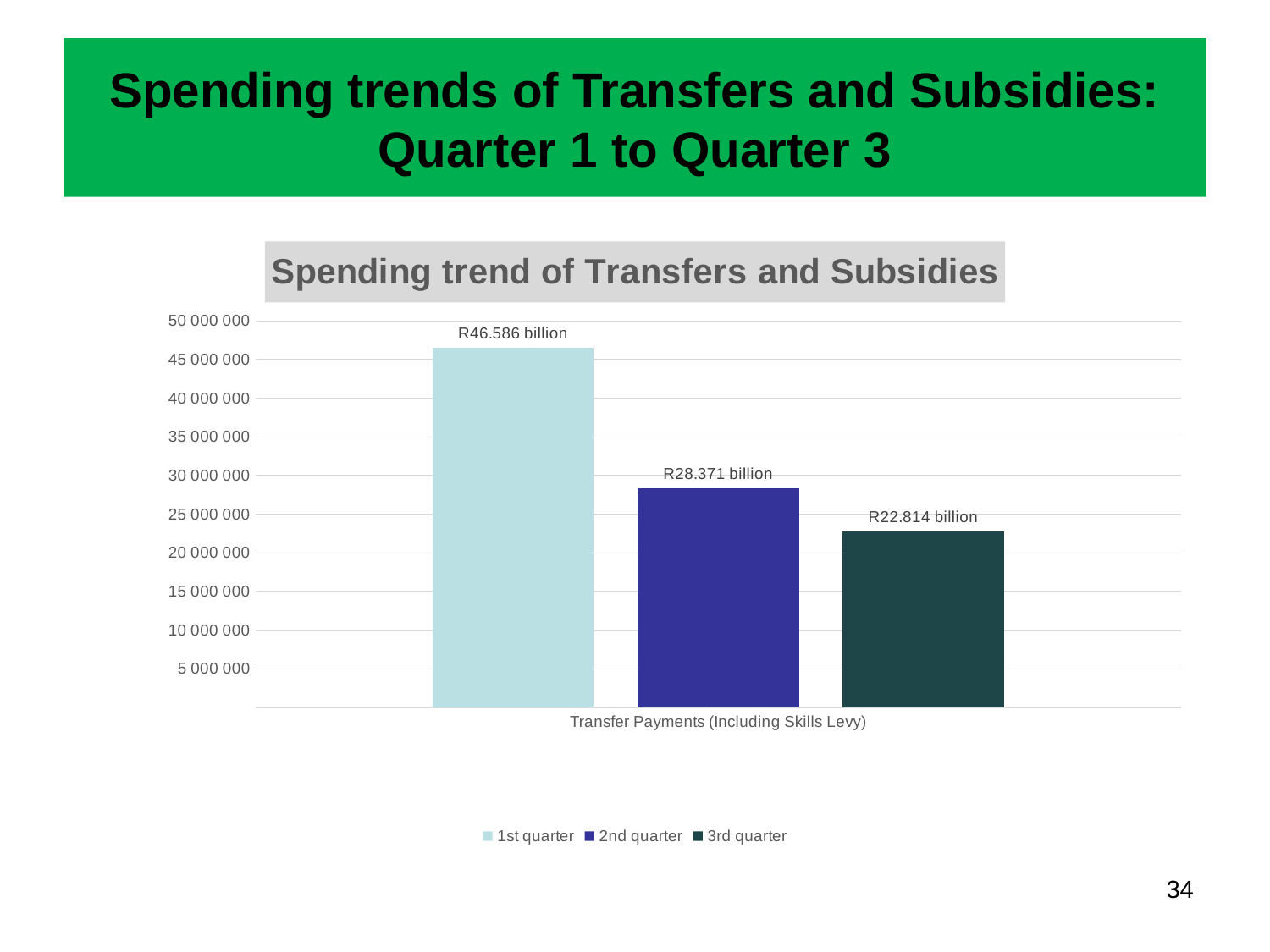
What is the value for the 1st quarter? R46.586 billion What kind of chart is shown? bar chart What is the difference between the 2nd quarter and the 3rd quarter values? R5.557 billion What is the value for the 2nd quarter? R28.371 billion What is the difference between the 1st quarter and the 2nd quarter values? R18.215 billion Do the values rise or fall from the 1st quarter to the 3rd quarter? fall How many series does the legend list? 3 What is the value for the 3rd quarter? R22.814 billion Which quarter has the highest spending? 1st quarter Which quarter has the lowest spending? 3rd quarter Which is larger, the 2nd quarter value or the 3rd quarter value? 2nd quarter Is the value for the 3rd quarter greater or less than 25 000 000? less